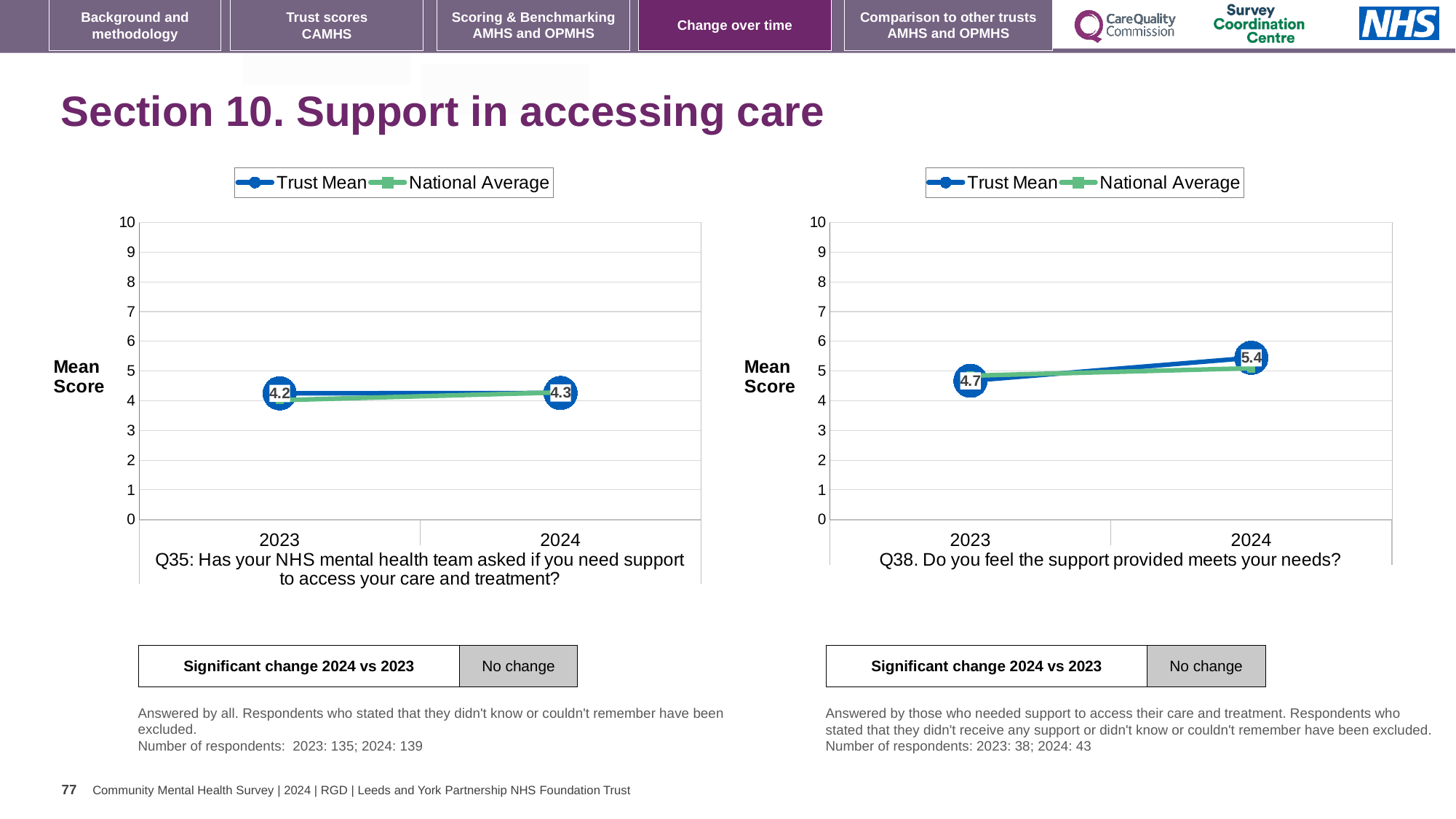
On the Q35 chart (left), what is the Trust Mean score for 2023? 4.2 On the Q38 chart (right), what is the Trust Mean score for 2024? 5.4 On the Q38 chart (right), does the Trust Mean rise or fall from 2023 to 2024? rise On the Q38 chart (right), is the Trust Mean for 2024 greater or less than 5? greater On the Q38 chart (right), what is the Trust Mean score for 2023? 4.7 On the Q38 chart (right), which year has the higher Trust Mean score? 2024 On the Q35 chart (left), what is the Trust Mean score for 2024? 4.3 On the Q35 chart (left), is the Trust Mean for 2024 greater or less than 5? less On the Q38 chart (right), by how much did the Trust Mean change from 2023 to 2024? 0.7 On the Q35 chart (left), what is the difference between the Trust Mean in 2024 and 2023? 0.1 How many series does the legend of the Q35 chart (left) list? 2 What type of chart is the Q38 chart (right)? line chart